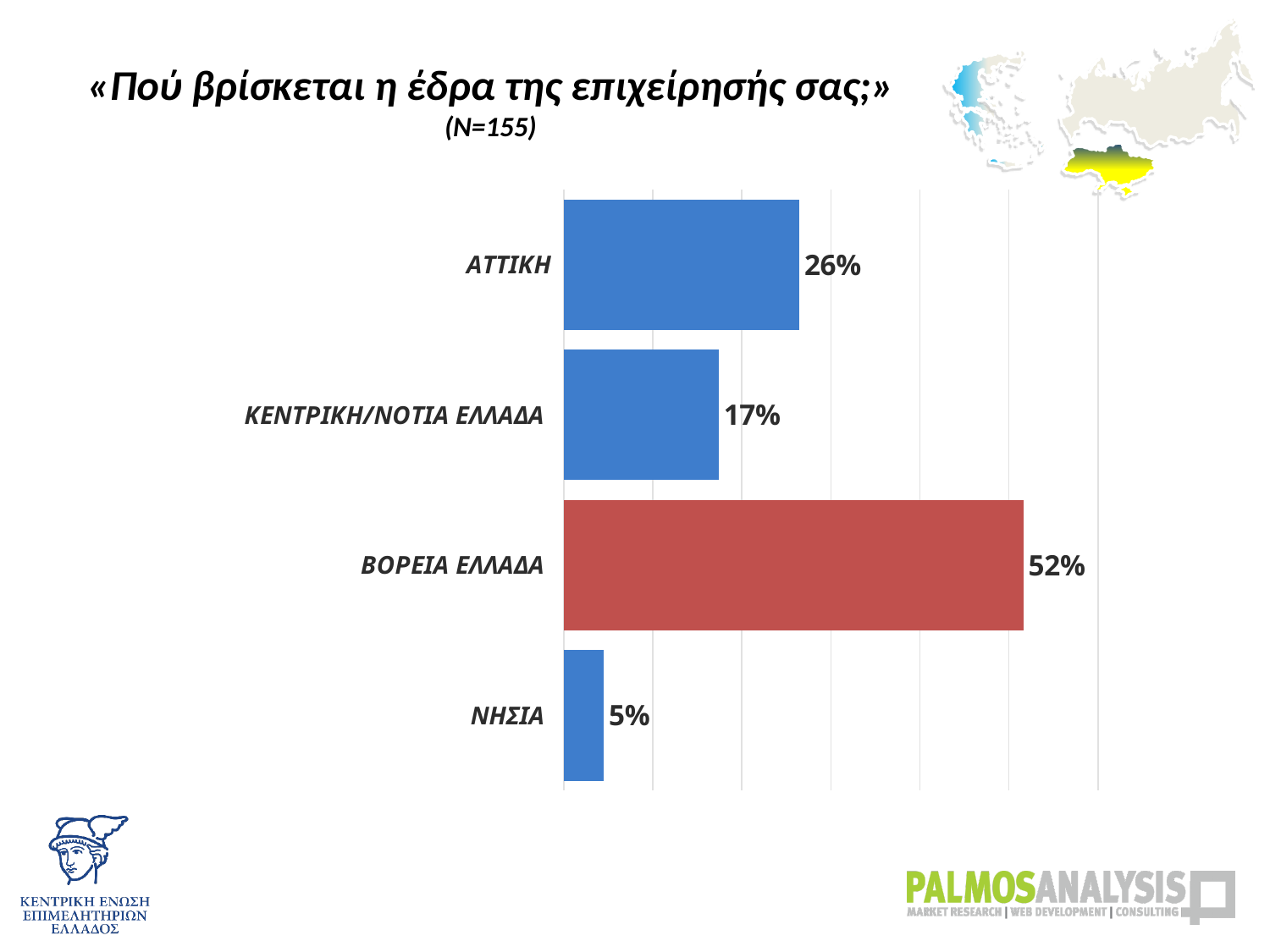
What is the value for ΚΕΝΤΡΙΚΗ/ΝΟΤΙΑ ΕΛΛΑΔΑ? 17% What is the value for ΒΟΡΕΙΑ ΕΛΛΑΔΑ? 52% What kind of chart is shown on the slide? Bar chart Which bar is coloured red rather than blue? ΒΟΡΕΙΑ ΕΛΛΑΔΑ What is the difference between the values for ΒΟΡΕΙΑ ΕΛΛΑΔΑ and ΑΤΤΙΚΗ? 26% Which is larger, the value for ΚΕΝΤΡΙΚΗ/ΝΟΤΙΑ ΕΛΛΑΔΑ or the value for ΝΗΣΙΑ? ΚΕΝΤΡΙΚΗ/ΝΟΤΙΑ ΕΛΛΑΔΑ What is the difference between the values for ΑΤΤΙΚΗ and ΚΕΝΤΡΙΚΗ/ΝΟΤΙΑ ΕΛΛΑΔΑ? 9% How many categories are shown in the chart? 4 What is the value for ΑΤΤΙΚΗ? 26% What is the value for ΝΗΣΙΑ? 5% Which category has the highest value? ΒΟΡΕΙΑ ΕΛΛΑΔΑ Which category has the lowest value? ΝΗΣΙΑ